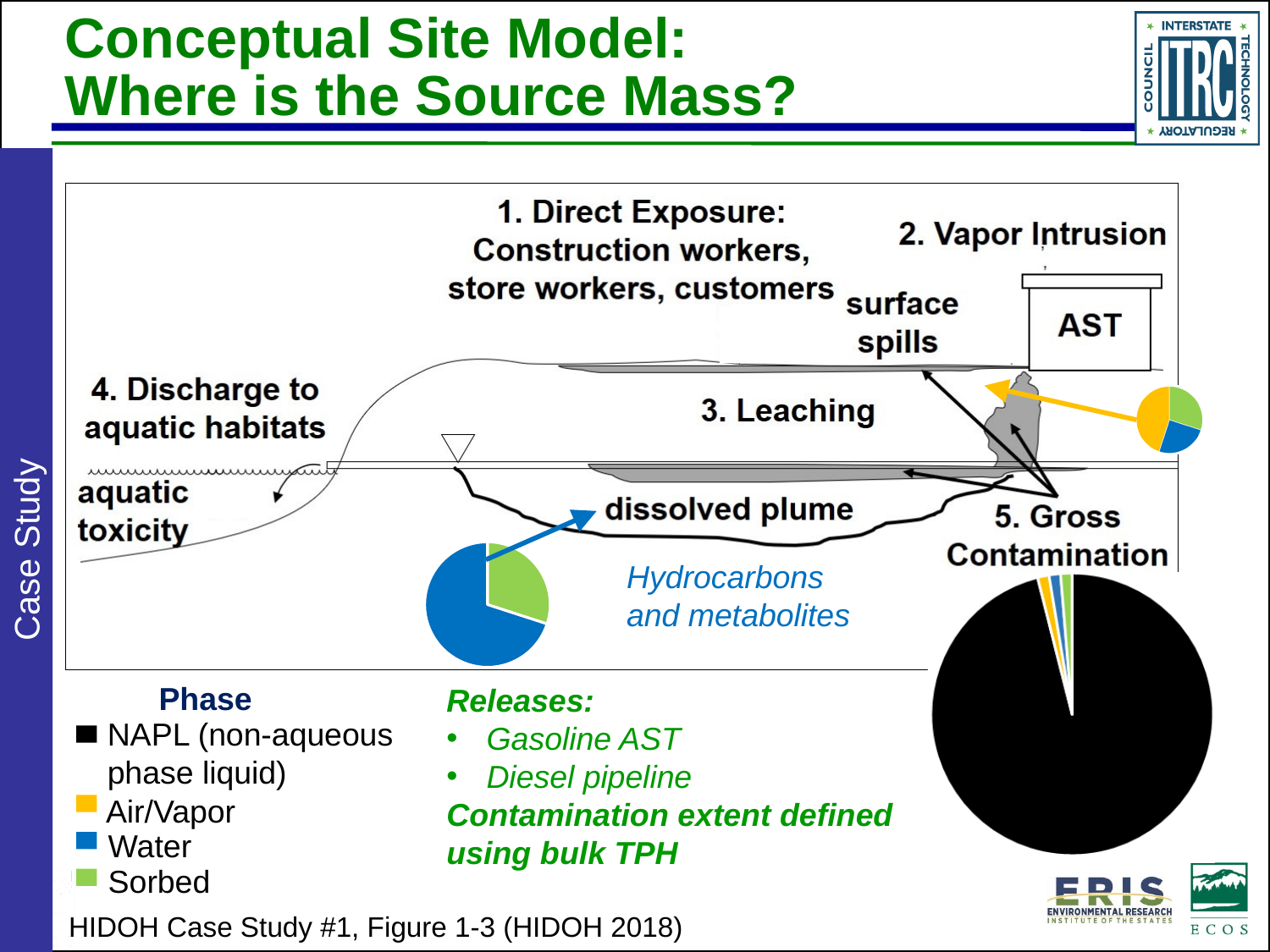
In the small pie chart next to the AST, which phase has the largest share? Air/Vapor In the pie chart below 'dissolved plume', is the Water share larger or smaller than the Sorbed share? larger In the pie chart below 'dissolved plume', which phase has the smallest share? Sorbed How many slices does the small pie chart next to the AST have? 3 In the large pie chart next to '5. Gross Contamination', is the NAPL share larger or smaller than the Water share? larger What kind of chart is used to show the phase distribution at the gross contamination location? pie chart How many slices does the pie chart below 'dissolved plume' have? 2 In the large pie chart next to '5. Gross Contamination', which phase has the largest share? NAPL (non-aqueous phase liquid) What colour represents the Sorbed phase in the pie charts? green How many phases does the Phase legend list? 4 In the pie chart below 'dissolved plume', which phase has the largest share? Water What colour represents the NAPL phase in the pie charts? black